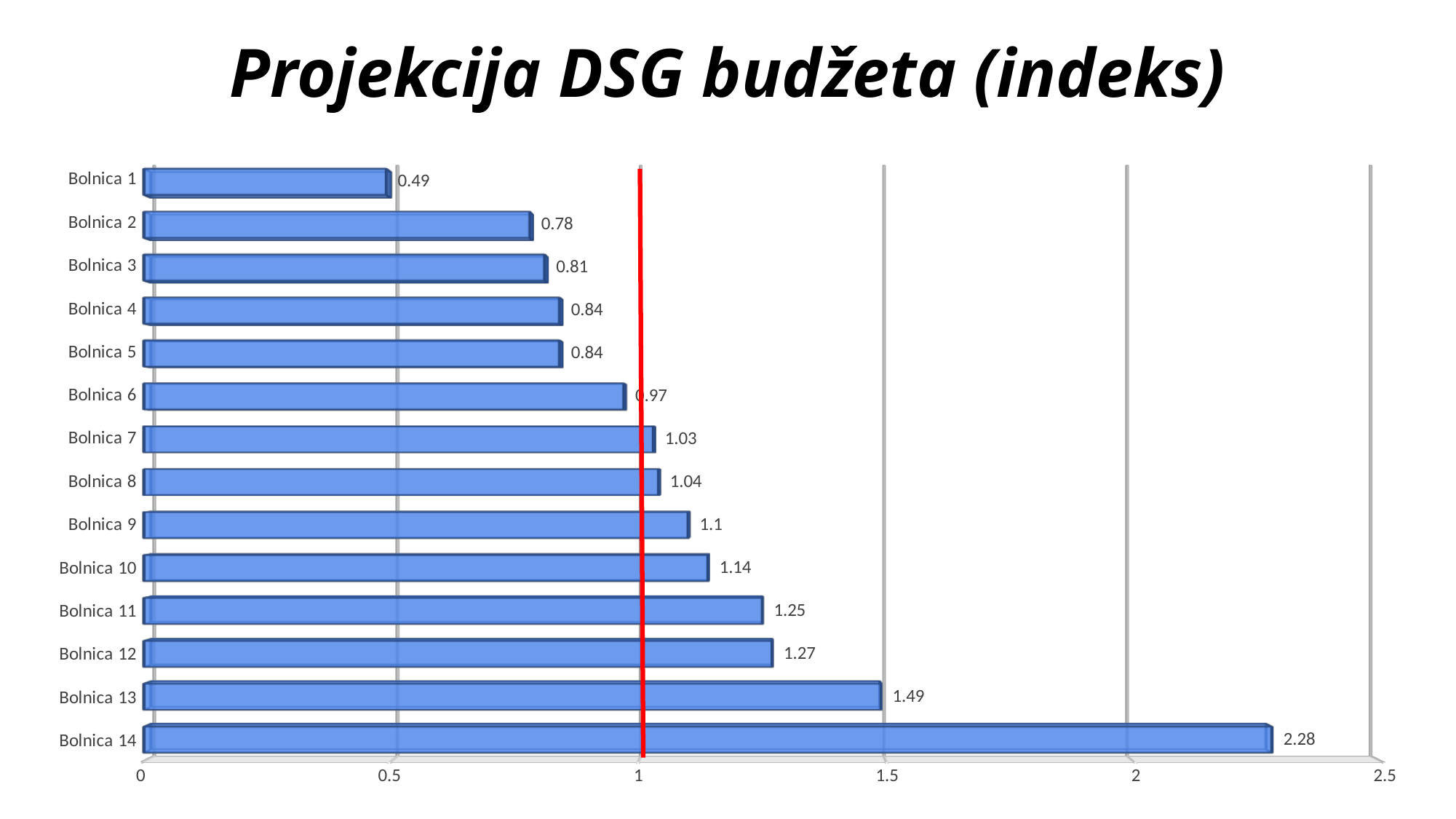
What is the value for Bolnica 9? 1.1 Is the value for Bolnica 12 greater or less than 1? greater What is the difference between the values for Bolnica 14 and Bolnica 13? 0.79 What is the value for Bolnica 1? 0.49 Which hospital has the highest value? Bolnica 14 What is the title of the chart? Projekcija DSG budžeta (indeks) What is the difference between the values for Bolnica 2 and Bolnica 1? 0.29 How many hospitals are shown in the chart? 14 What is the value for Bolnica 13? 1.49 What kind of chart is shown on the slide? bar chart Which hospital has the lowest value? Bolnica 1 Which is larger, the value for Bolnica 11 or the value for Bolnica 6? Bolnica 11